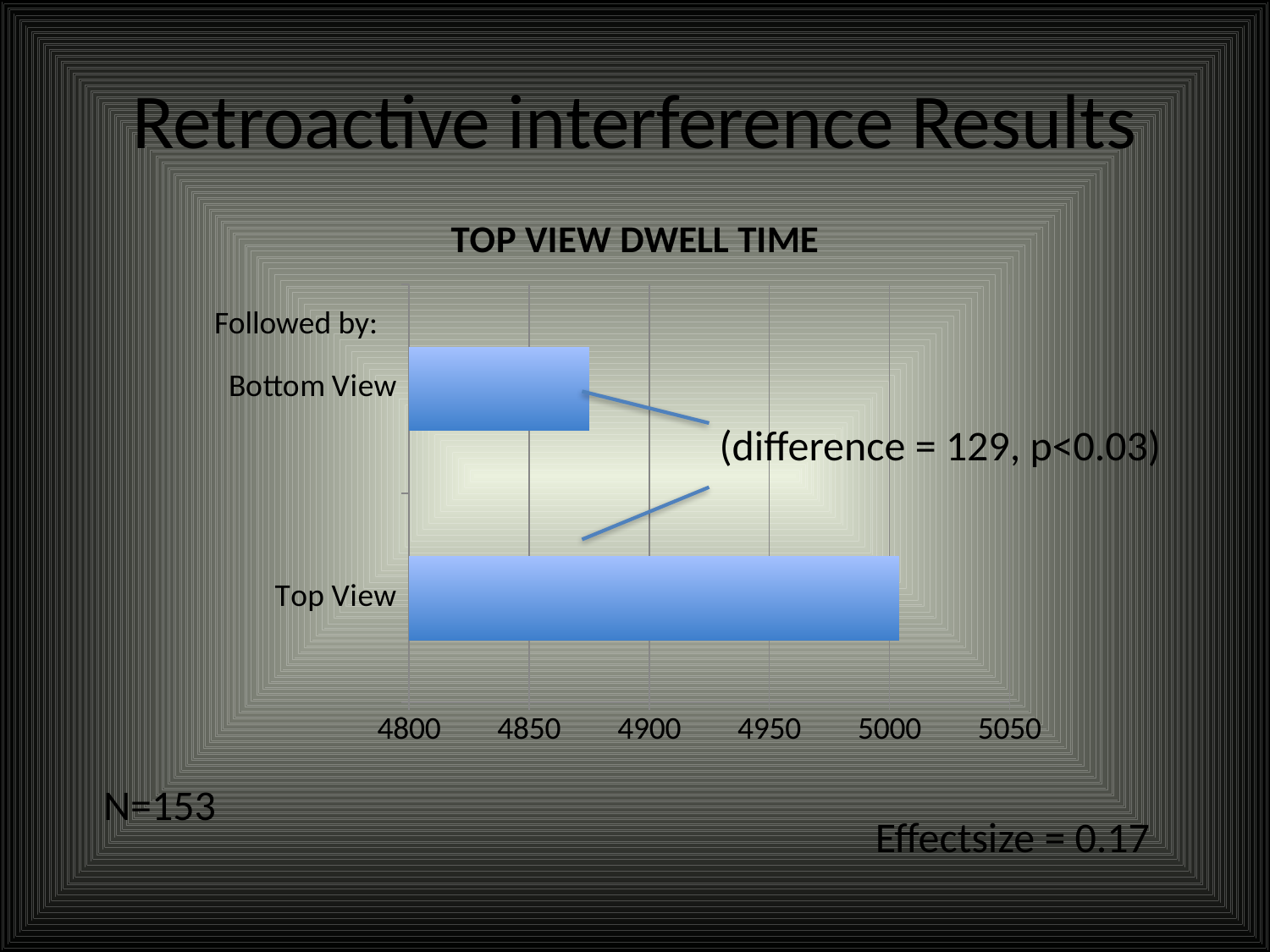
Is the value for Top View greater or less than 5050? less Is the value for Top View greater or less than 4950? greater Which is larger, the value for Top View or the value for Bottom View? Top View Which category has the highest dwell time? Top View What kind of chart is shown on the slide? bar chart According to the annotation on the chart, what is the difference between the two bars? 129 What is the title of the chart? TOP VIEW DWELL TIME Is the value for Bottom View greater or less than 4900? less How many categories (bars) does the chart show? 2 Which category has the lowest dwell time? Bottom View